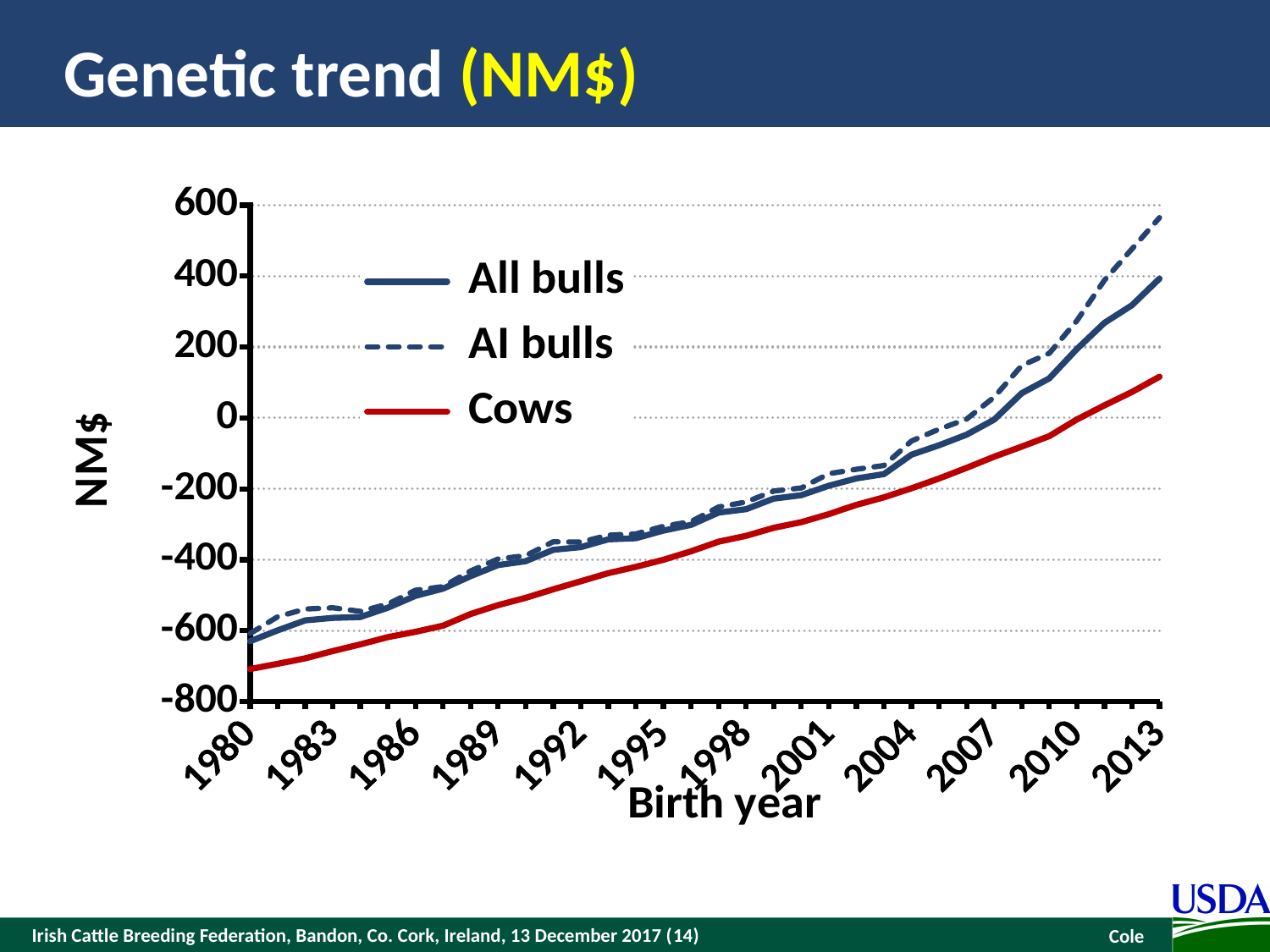
Do the NM$ values for Cows rise or fall from 1980 to 2013? rise Is the value for All bulls in 1995 greater or less than -200? less Is the value for Cows in 1980 greater or less than -600? less What are the three series named in the legend? All bulls, AI bulls, Cows Which series has the highest value in 2013? AI bulls How many series does the legend list? 3 What is the label of the x axis? Birth year In 2013, which is larger: the value for AI bulls or the value for Cows? AI bulls Is the value for Cows in 2013 greater or less than 0? greater What kind of chart is shown on the slide? line chart Which series has the lowest value in 1980? Cows